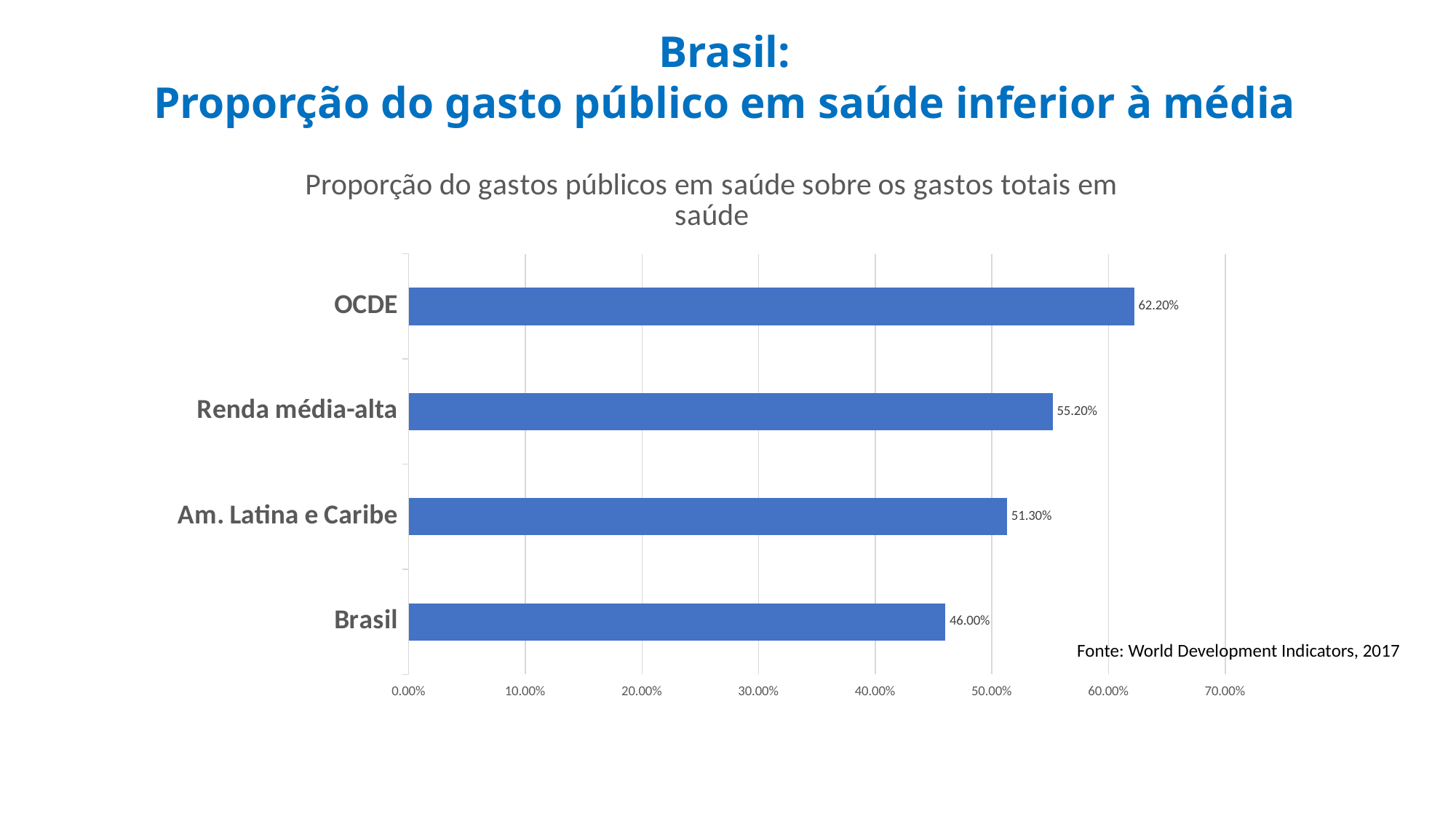
Is the value for Brasil greater or less than 50.00%? less What is the value for Am. Latina e Caribe? 51.30% Which category has the highest value? OCDE What is the title of the chart? Proporção do gastos públicos em saúde sobre os gastos totais em saúde How many categories are shown in the chart? 4 Which is larger, the value for Renda média-alta or the value for Am. Latina e Caribe? Renda média-alta What is the value for OCDE? 62.20% What is the value for Renda média-alta? 55.20% Which category has the lowest value? Brasil What kind of chart is shown on the slide? bar chart What is the value for Brasil? 46.00% What is the difference between the values for OCDE and Brasil? 16.20%